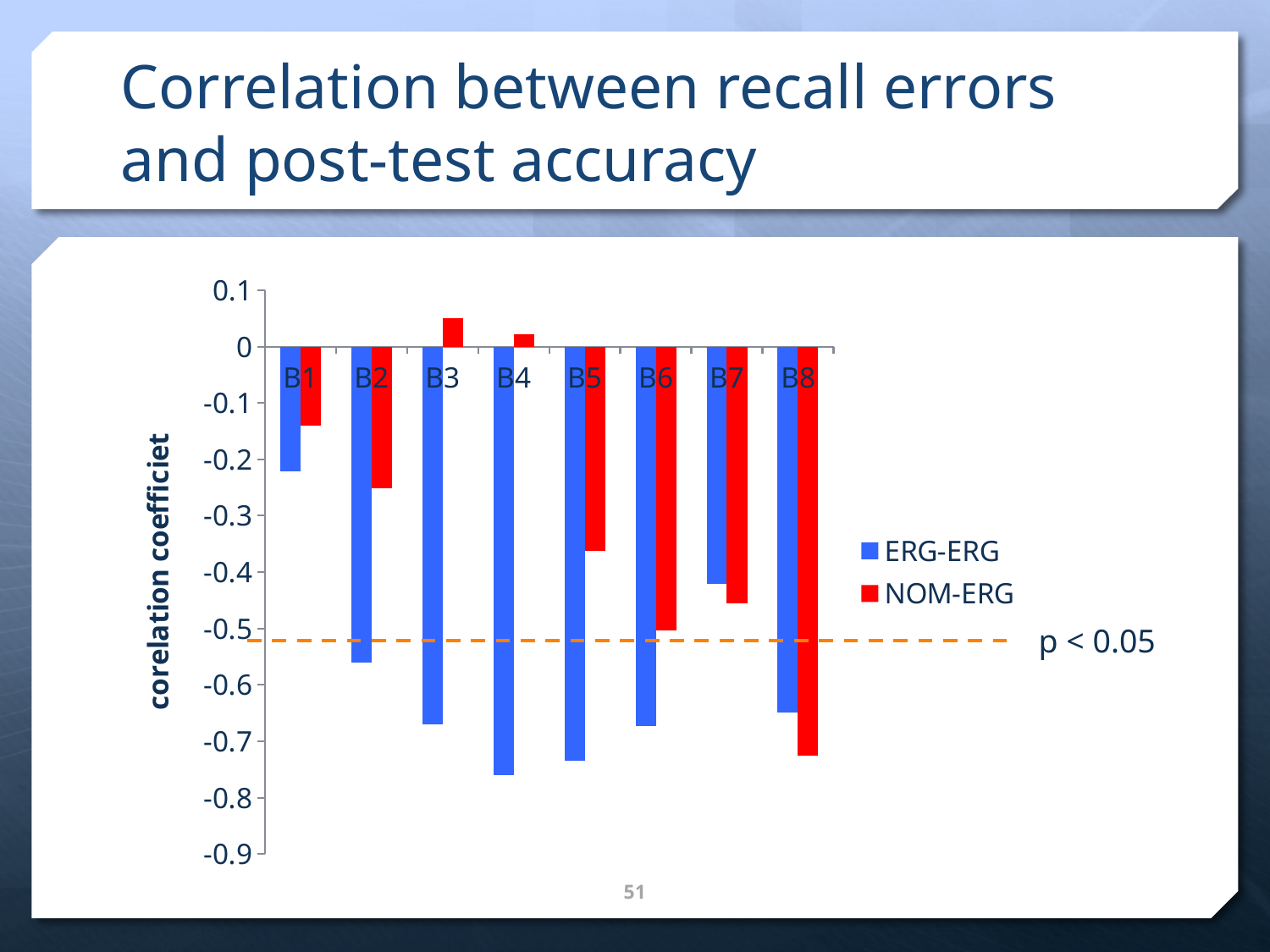
How many categories (B1 to B8) are plotted on the x axis? 8 For B3, which series has the larger value, ERG-ERG or NOM-ERG? NOM-ERG Is the ERG-ERG value for B1 greater or less than -0.3? greater For B8, which series has the larger value, ERG-ERG or NOM-ERG? ERG-ERG What kind of chart is shown on the slide? bar chart What label is given to the dashed horizontal line on the chart? p < 0.05 Which category has the highest ERG-ERG value? B1 Is the ERG-ERG value for B4 greater or less than -0.7? less Which category has the lowest NOM-ERG value? B8 Which category has the highest NOM-ERG value? B3 Is the NOM-ERG value for B5 greater or less than -0.3? less How many series does the legend list? 2